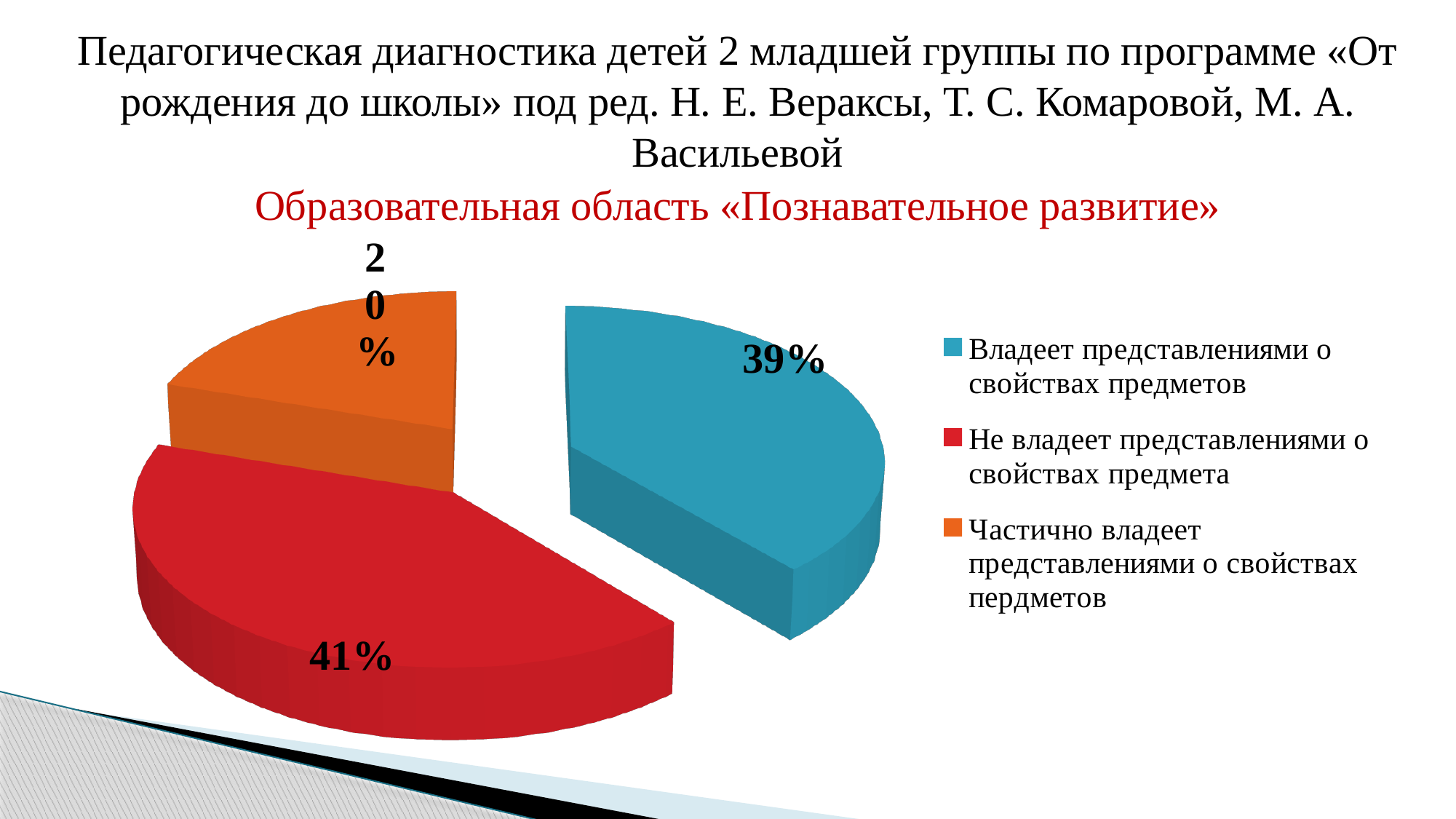
Which colour represents "Частично владеет представлениями о свойствах пердметов" in the pie chart? orange What kind of chart is shown on the slide? pie chart What percentage is shown for "Не владеет представлениями о свойствах предмета"? 41% Which category has the largest share of the pie? Не владеет представлениями о свойствах предмета What percentage is shown for "Владеет представлениями о свойствах предметов"? 39% How many slices does the pie chart have? 3 What is the difference between the share for "Владеет представлениями о свойствах предметов" and the share for "Частично владеет представлениями о свойствах пердметов"? 19% Which colour represents "Владеет представлениями о свойствах предметов" in the pie chart? blue What is the difference between the share for "Не владеет представлениями о свойствах предмета" and the share for "Владеет представлениями о свойствах предметов"? 2% What percentage is shown for "Частично владеет представлениями о свойствах пердметов"? 20% How many entries does the legend of the pie chart list? 3 Which category has the smallest share of the pie? Частично владеет представлениями о свойствах пердметов